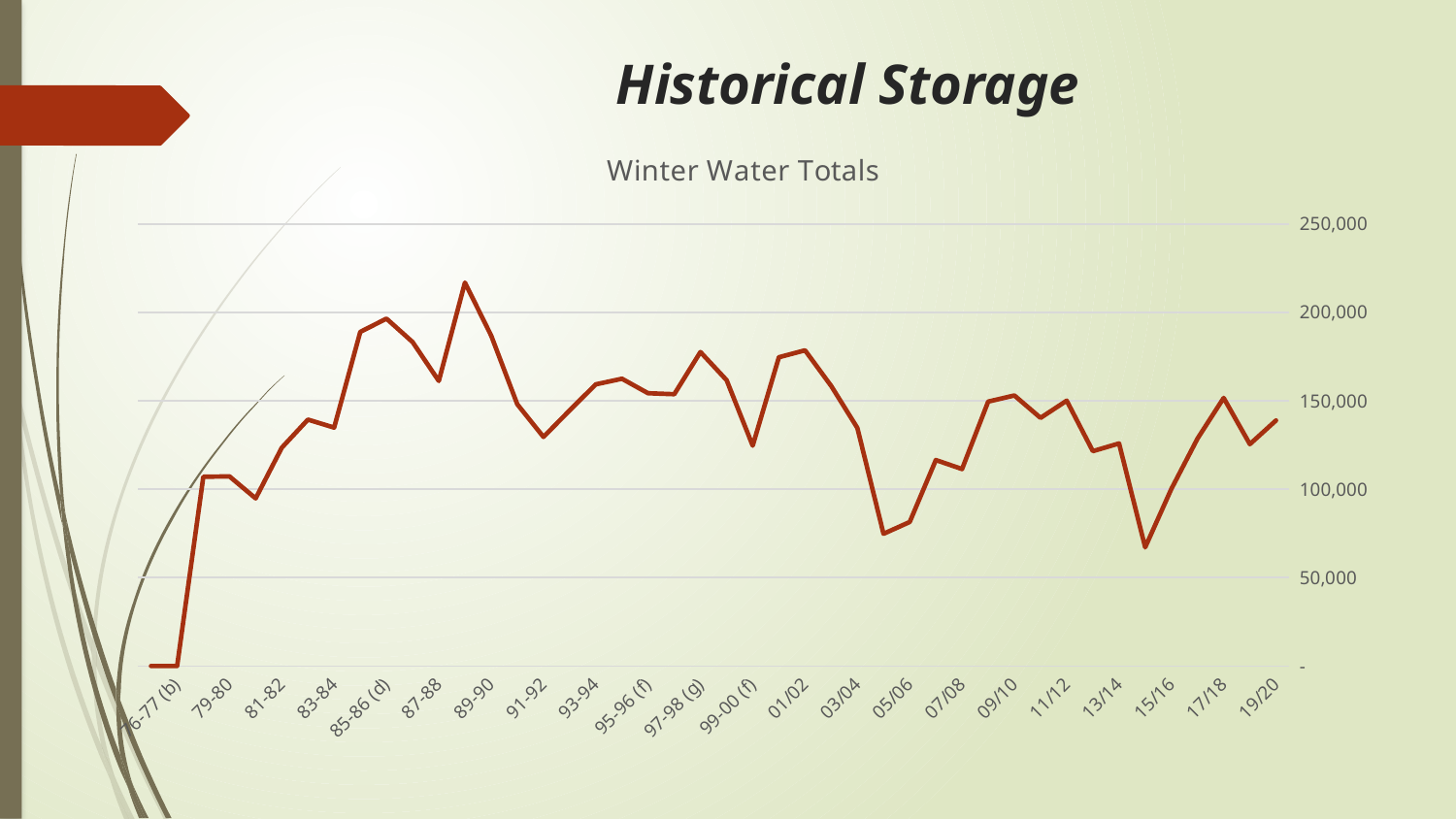
Is the value for 05/06 greater or less than 100,000? less Is the value for 89-90 greater or less than 200,000? less Is the value for 19/20 greater or less than 150,000? less What kind of chart is shown on the slide? line chart What is the title of the chart? Winter Water Totals Which has the larger value, 89-90 or 19/20? 89-90 Which has the larger value, 85-86 (d) or 05/06? 85-86 (d) How many year labels are shown on the x axis? 22